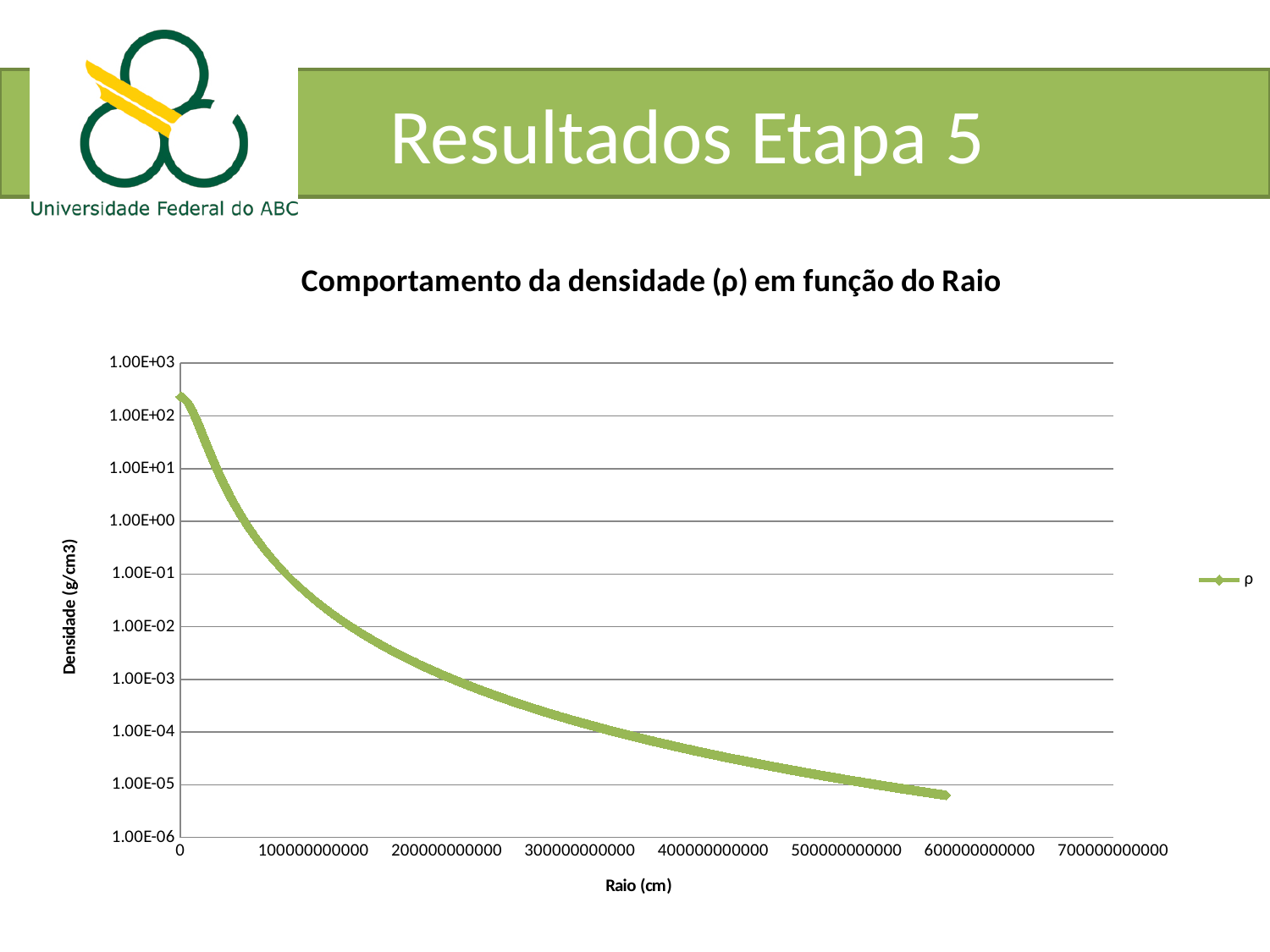
Is the largest Raio value plotted greater or less than 600000000000? less Is the density at Raio 400000000000 greater or less than 1.00E-04? less Is the density at Raio 100000000000 greater or less than 1.00E+00? less What is the label of the series in the legend? ρ Does the density rise or fall as the radius (Raio) increases along the x axis? fall What is the title of the chart? Comportamento da densidade (ρ) em função do Raio How many series does the legend list? 1 What kind of chart is shown on the slide? line chart At which end of the x axis is the density highest, Raio 0 or the largest Raio plotted? Raio 0